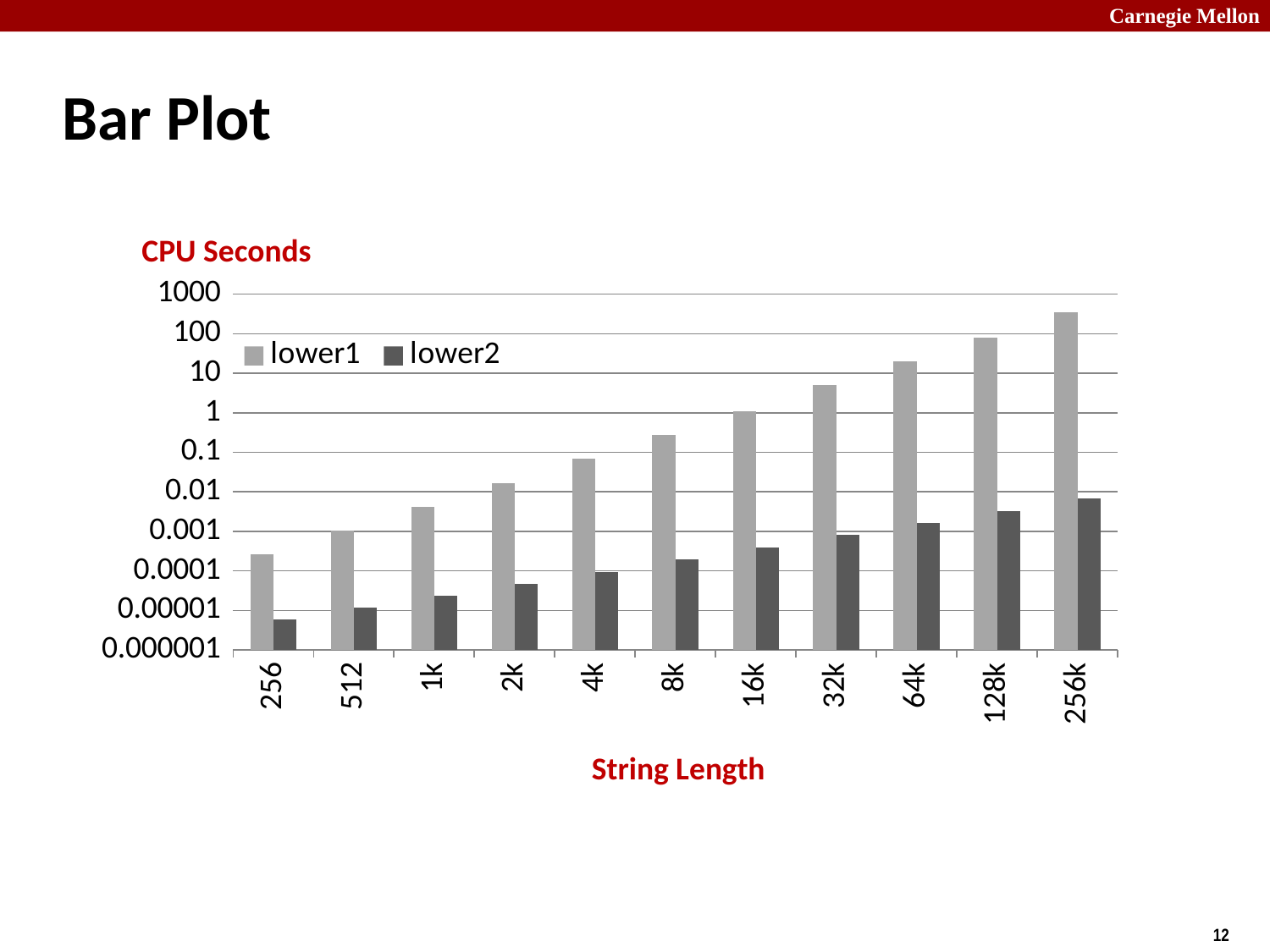
What is the label on the vertical axis of the chart? CPU Seconds Is the lower1 value for string length 256k greater or less than 100? greater At string length 4k, which series has the larger value, lower1 or lower2? lower1 Is the lower1 value for string length 64k greater or less than 10? greater How many string length categories are shown on the x axis? 11 What kind of chart is shown on the slide? bar chart How many series does the legend list? 2 Is the lower2 value for string length 256k greater or less than 0.01? less Do the lower1 values rise or fall as string length increases along the x axis? rise For which string length is the lower1 value highest? 256k For which string length is the lower2 value lowest? 256